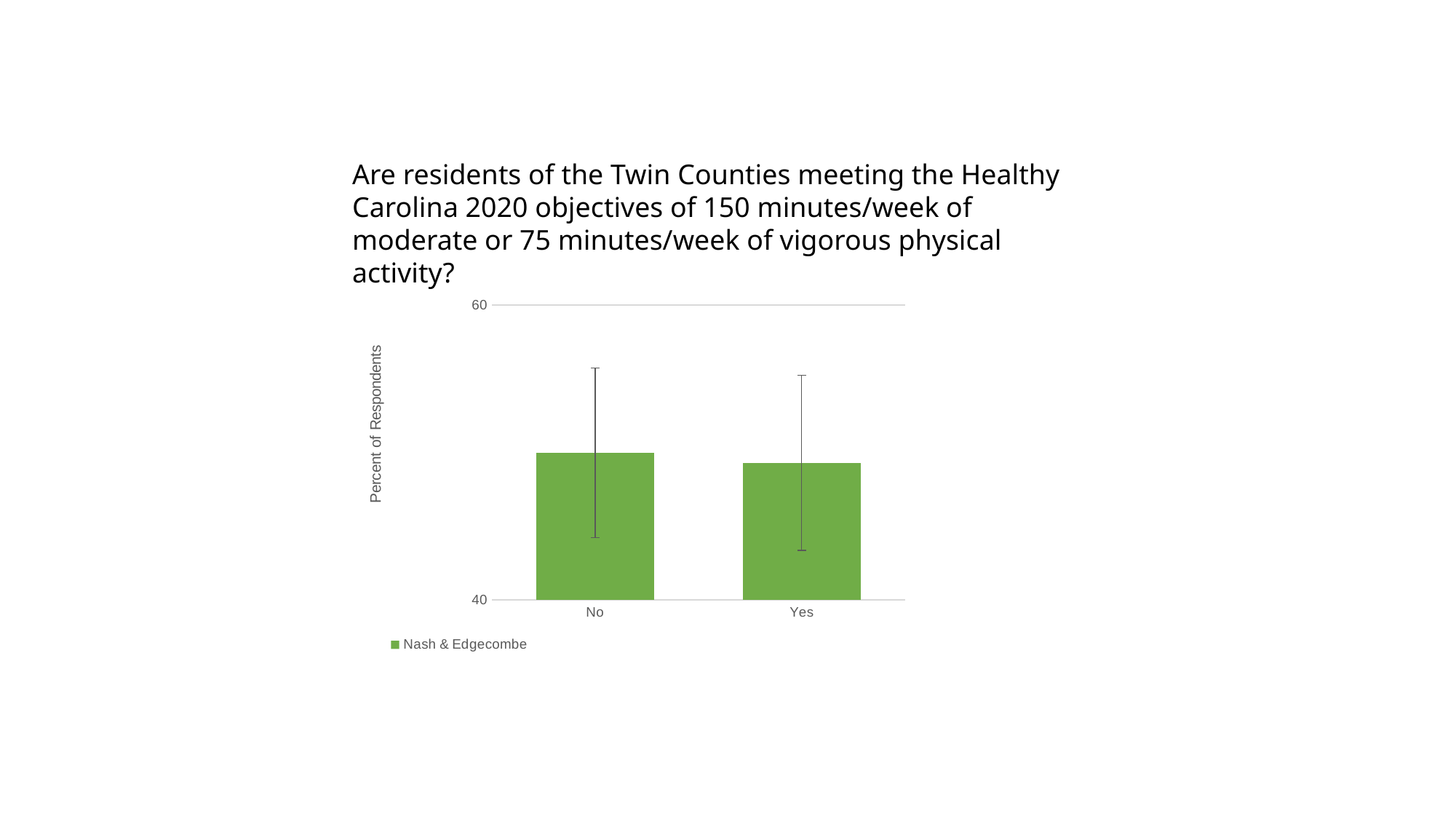
Is the value for Yes greater or less than 60? less What is the label on the chart's vertical axis? Percent of Respondents What kind of chart is shown on the slide? bar chart Is the value for No greater or less than 40? greater How many categories are shown on the x axis of the chart? 2 How many series does the chart's legend list? 1 What series name is shown in the chart's legend? Nash & Edgecombe Is the value for Yes greater or less than 40? greater